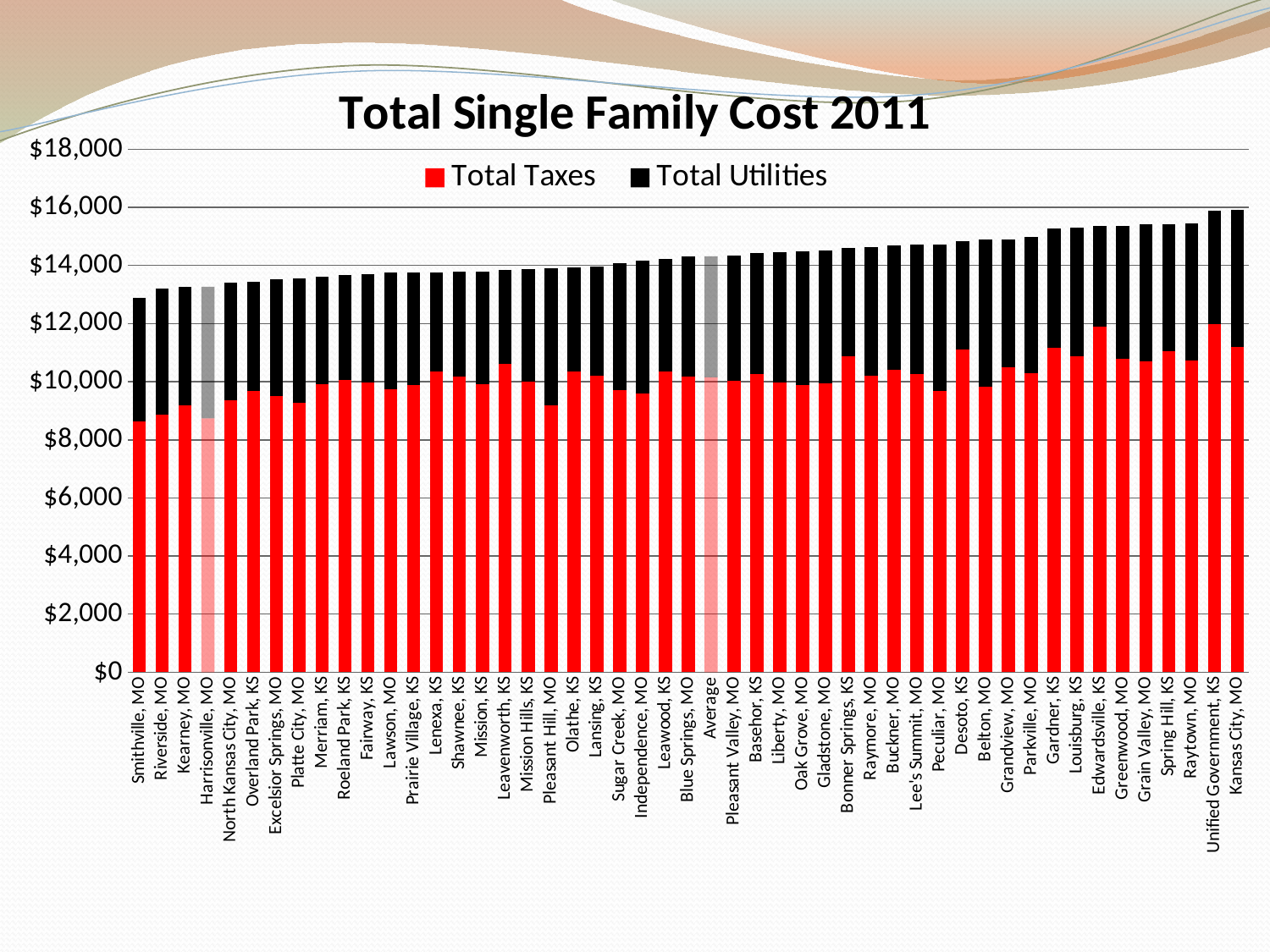
Which colour represents Total Taxes in the chart? Red Do the total single family costs generally rise or fall from left to right across the chart? Rise Is the total single family cost for Smithville, MO greater or less than $14,000? less What is the title of the chart? Total Single Family Cost 2011 What kind of chart is shown on the slide? Stacked bar chart Which has the larger total single family cost, Smithville, MO or Kansas City, MO? Kansas City, MO Is the total single family cost for Kansas City, MO greater or less than $14,000? greater How many series does the legend list? 2 Is the Total Taxes value for Unified Government, KS greater or less than $10,000? greater Which city has the lowest total single family cost? Smithville, MO